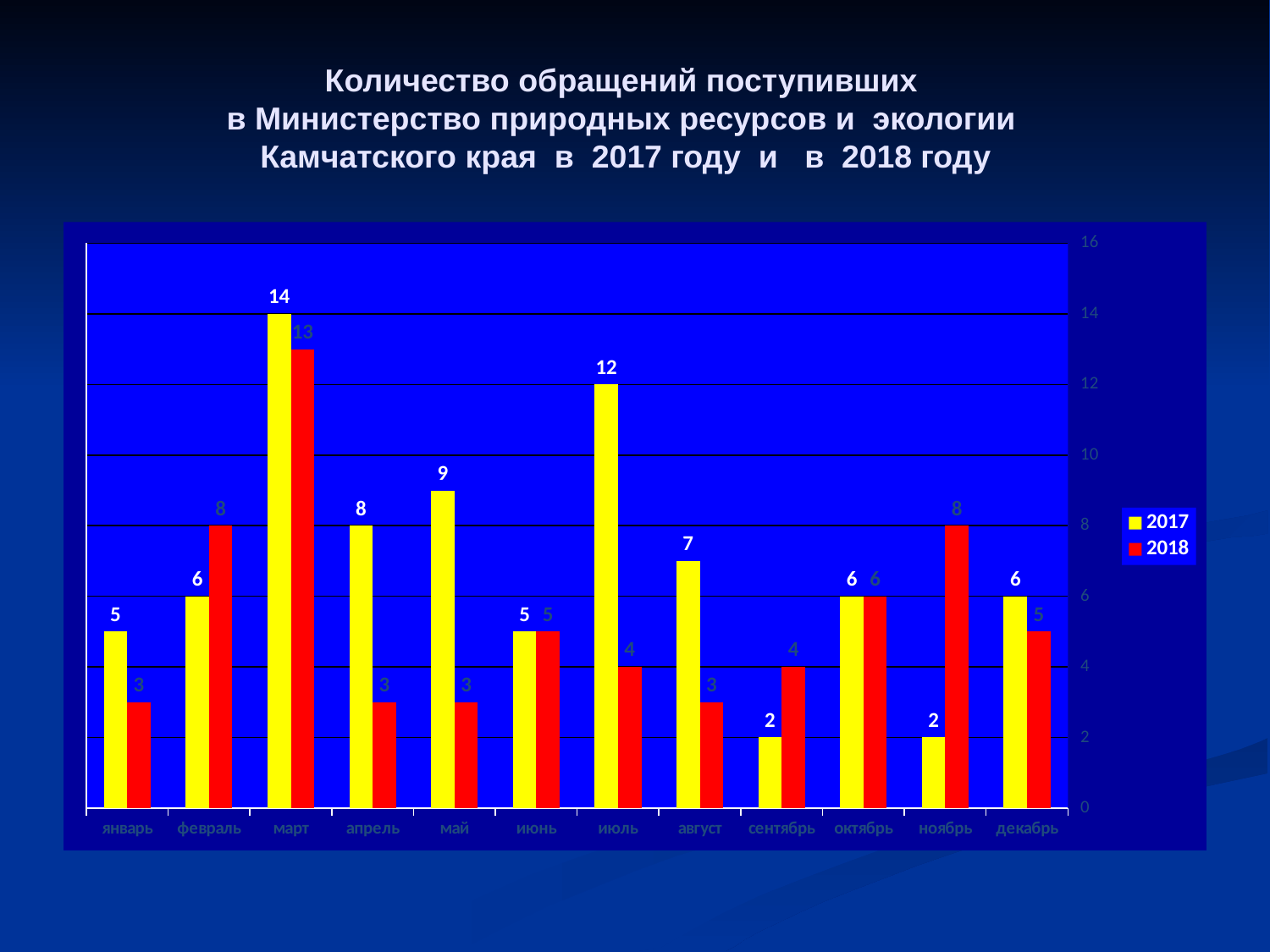
What is the difference between the 2017 and 2018 values in июль? 8 What is the value for 2017 in июль? 12 How many months (categories) are shown on the x axis? 12 Which is larger in февраль: the 2017 value or the 2018 value? 2018 Which month has the highest value for the 2017 series? март Which colour represents the 2018 series in the legend? red How many series does the legend list? 2 What is the value for 2018 in ноябрь? 8 What type of chart is shown on the slide? bar chart What is the difference between the 2017 value in март and the 2017 value in апрель? 6 What is the value for 2017 in март? 14